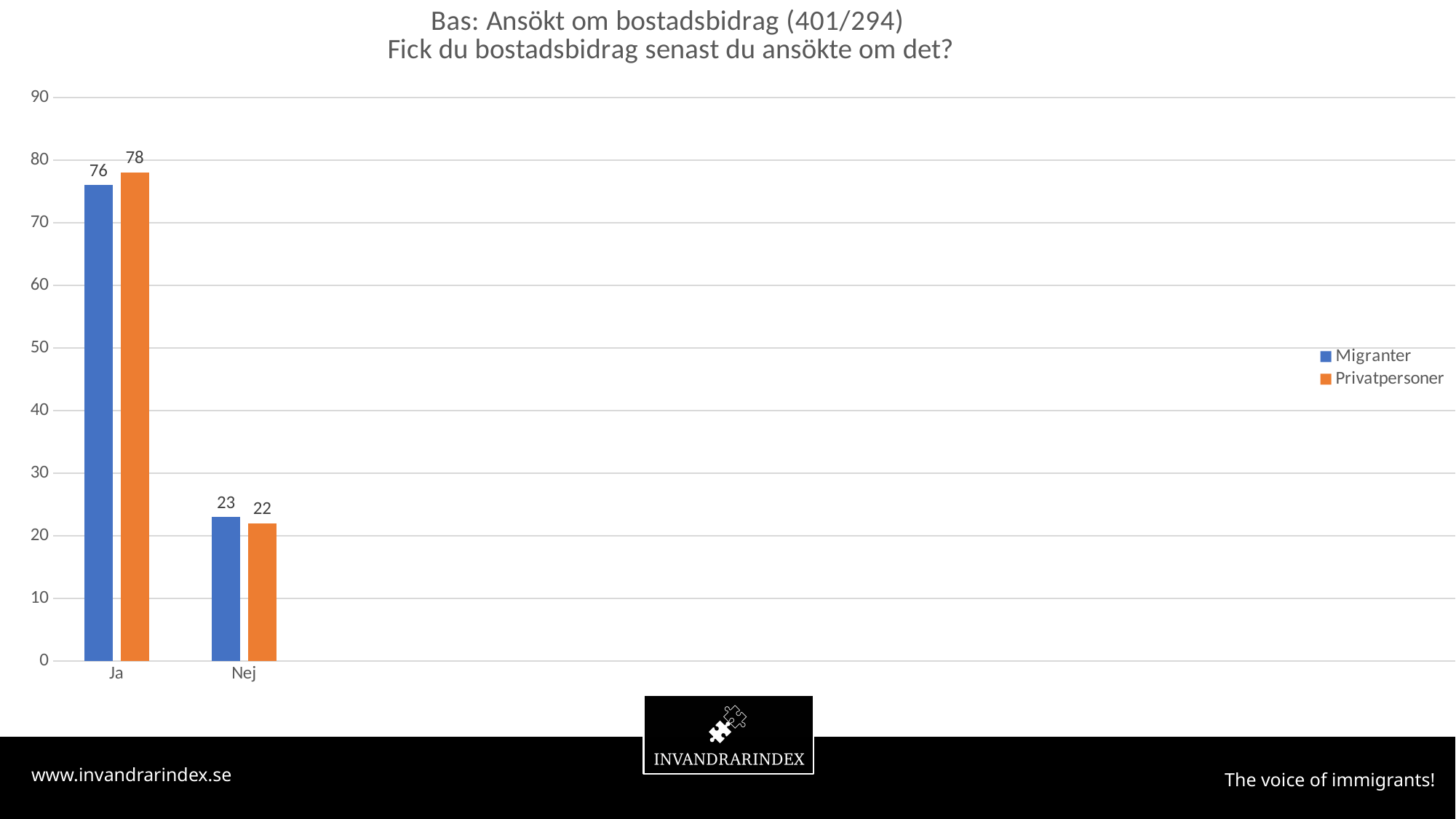
Which category has the highest value for Privatpersoner? Ja What kind of chart is shown on the slide? Bar chart What is the value for Migranter in the Nej category? 23 What is the value for Privatpersoner in the Nej category? 22 What is the difference between the Migranter values for Ja and Nej? 53 How many categories are shown on the x axis? 2 Which is larger: the Migranter value for Ja or the Migranter value for Nej? Ja Which category has the lowest value for Migranter? Nej How many series does the legend list? 2 What is the value for Migranter in the Ja category? 76 What is the difference between the Privatpersoner and Migranter values in the Ja category? 2 What is the value for Privatpersoner in the Ja category? 78